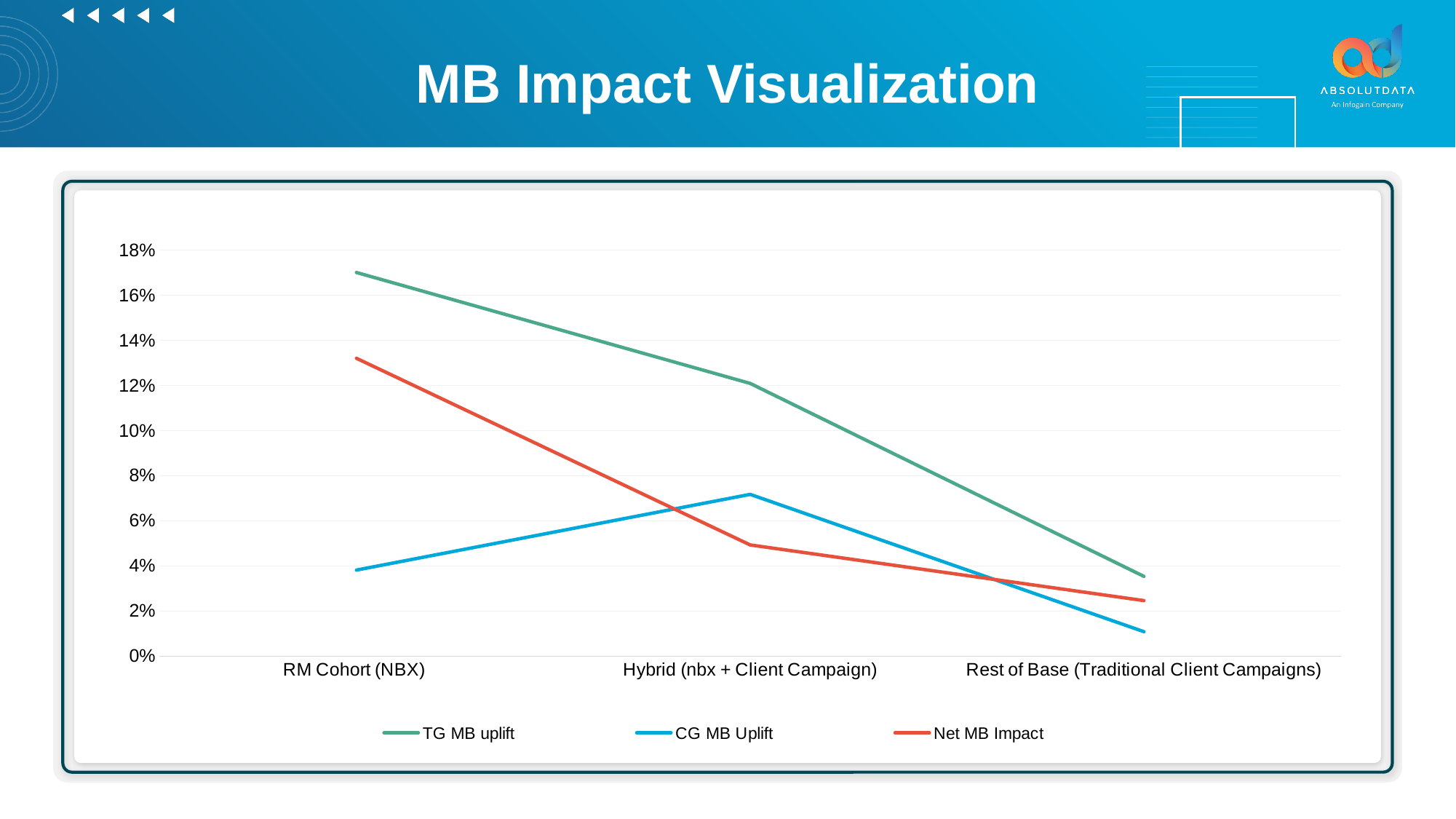
Which category has the highest CG MB Uplift? Hybrid (nbx + Client Campaign) Is the CG MB Uplift for Rest of Base (Traditional Client Campaigns) greater or less than 2%? less How many series does the legend list? 3 Which category has the lowest CG MB Uplift? Rest of Base (Traditional Client Campaigns) What kind of chart is shown on the slide? line chart Is the TG MB uplift for RM Cohort (NBX) greater or less than 16%? greater How many categories are shown on the x axis? 3 Which category has the highest TG MB uplift? RM Cohort (NBX) Which series is drawn in red? Net MB Impact At Hybrid (nbx + Client Campaign), which is larger: TG MB uplift or CG MB Uplift? TG MB uplift Does the TG MB uplift rise or fall from RM Cohort (NBX) to Rest of Base (Traditional Client Campaigns)? fall Is the Net MB Impact for Hybrid (nbx + Client Campaign) greater or less than 6%? less